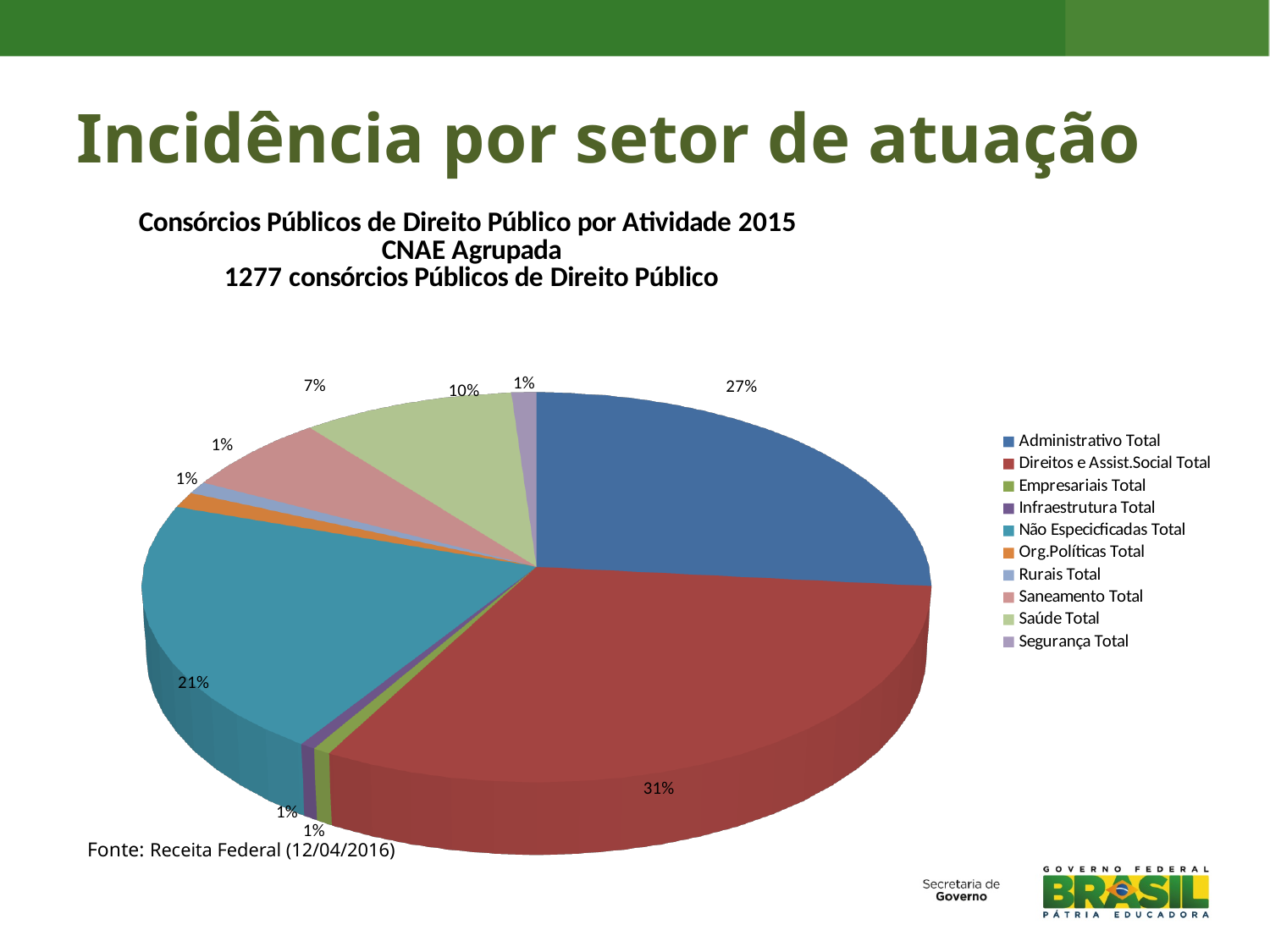
What is the value shown for Saneamento Total? 7% What is the difference in percentage points between Saúde Total and Saneamento Total? 3 What kind of chart is shown on the slide? pie chart How many categories does the legend list? 10 Which is larger, Administrativo Total or Não Especicficadas Total? Administrativo Total What is the difference in percentage points between Direitos e Assist.Social Total and Administrativo Total? 4 What is the value shown for Administrativo Total? 27% What is the value shown for Saúde Total? 10% What is the value shown for Não Especicficadas Total? 21% Which category has the largest slice of the pie? Direitos e Assist.Social Total What share of the pie does Direitos e Assist.Social Total represent? 31% According to the chart subtitle, how many consórcios Públicos de Direito Público are represented? 1277